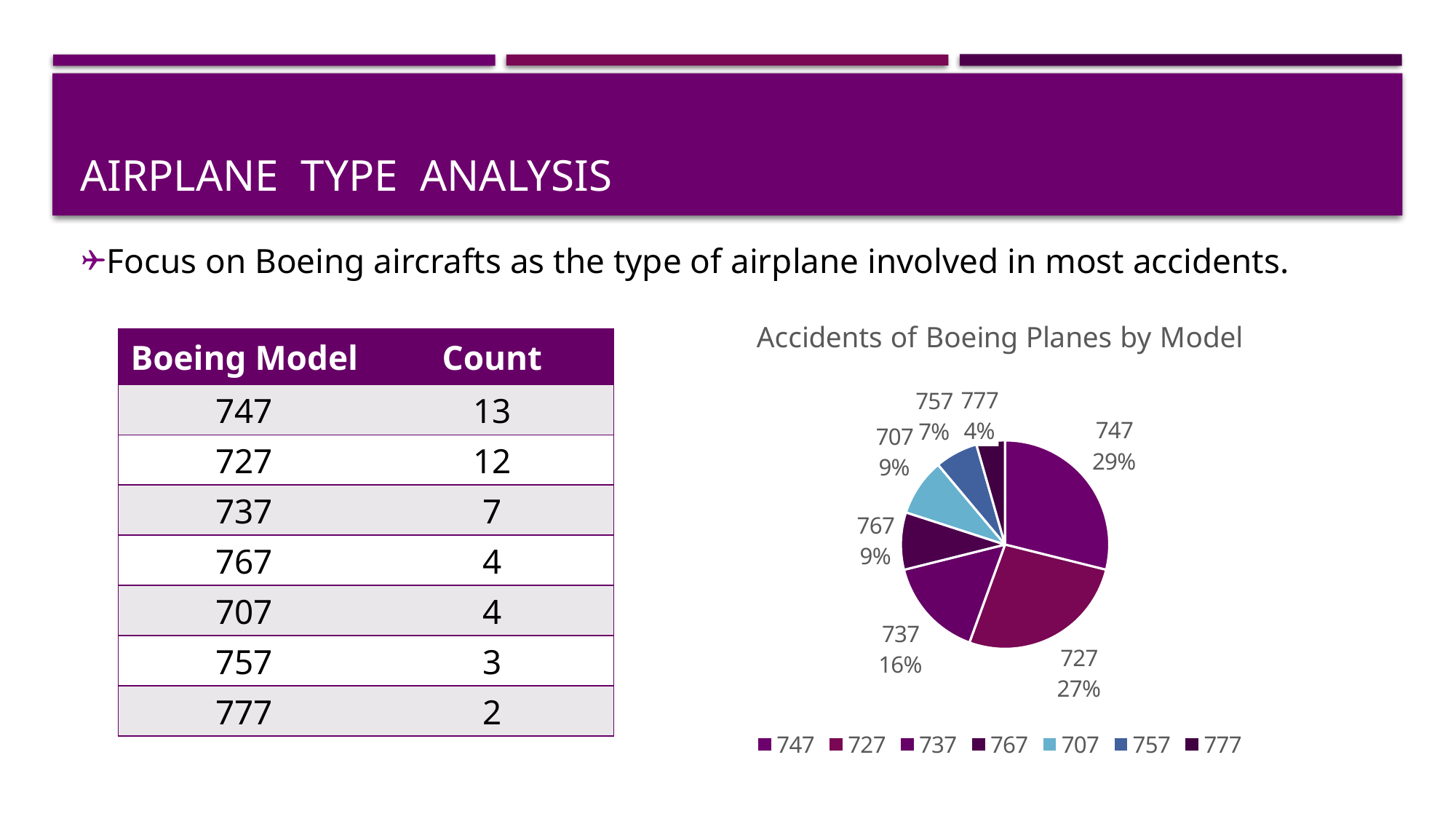
What percentage is shown for the 737 slice? 16% Which model has the largest slice of the pie? 747 What percentage is shown for the 757 slice? 7% What share of the pie does the 727 model have? 27% What share of the pie does the 747 model have? 29% Which slice is larger, 737 or 707? 737 Which model has the smallest slice of the pie? 777 What is the difference in percentage points between the 747 slice and the 777 slice? 25 How many slices does the pie chart have? 7 How many entries does the legend list? 7 What is the title of the pie chart? Accidents of Boeing Planes by Model What kind of chart is shown on the slide? pie chart